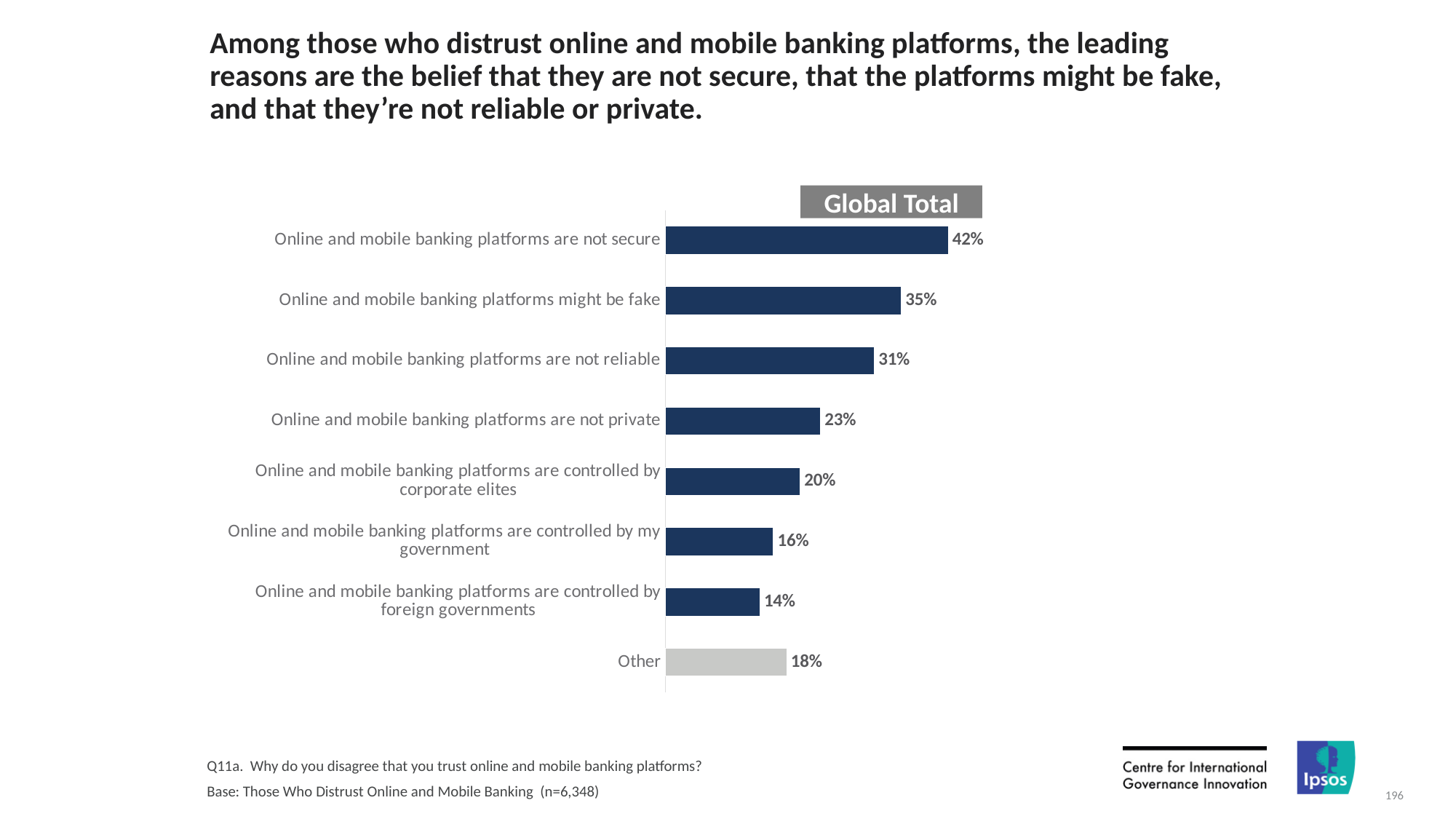
What is the value for 'Online and mobile banking platforms might be fake'? 35% How many categories are shown in the chart? 8 What percentage said online and mobile banking platforms are controlled by foreign governments? 14% Which reason has the highest percentage? Online and mobile banking platforms are not secure What percentage of respondents said online and mobile banking platforms are not secure? 42% What type of chart is shown on the slide? Bar chart What is the difference between the percentage for 'not secure' and the percentage for 'not private'? 19 percentage points What is the label shown in the grey box above the chart? Global Total Which reason has the lowest percentage? Online and mobile banking platforms are controlled by foreign governments Which is larger: the value for 'controlled by corporate elites' or the value for 'controlled by my government'? Controlled by corporate elites What is the value shown for the 'Other' category? 18% Which bar is coloured grey rather than dark blue? Other